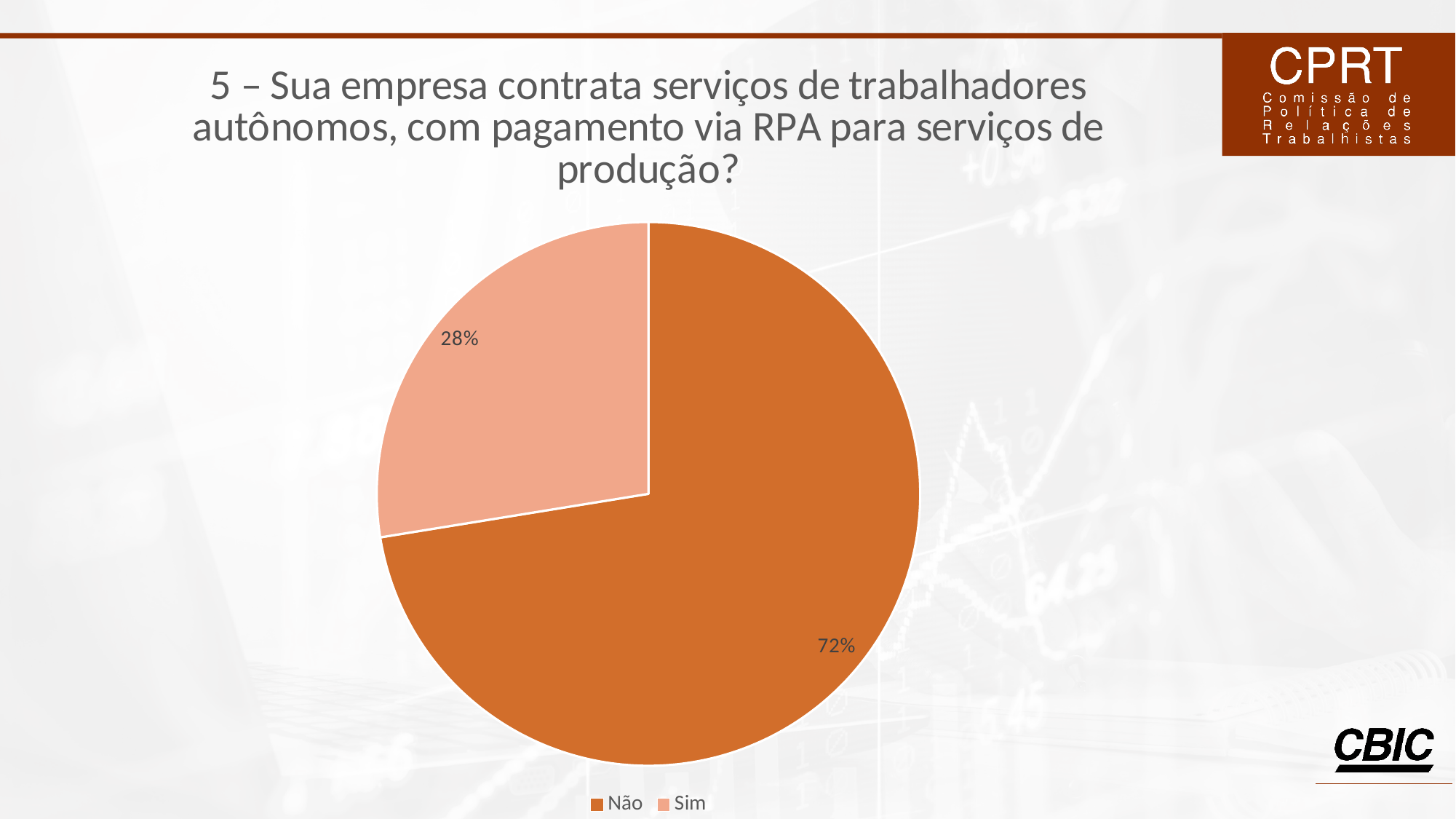
Which legend entry is shown in the darker orange colour? Não What percentage of the pie is labelled "Sim"? 28% What is the title of the chart on the slide? 5 – Sua empresa contrata serviços de trabalhadores autônomos, com pagamento via RPA para serviços de produção? What is the difference in percentage points between the "Não" and "Sim" slices? 44 What share of the pie does the "Sim" slice represent? 28% Which is larger, the "Sim" slice or the "Não" slice? Não Which slice of the pie is the largest? Não What percentage of the pie is labelled "Não"? 72% Which slice of the pie is the smallest? Sim How many slices does the pie chart have? 2 How many entries does the legend list? 2 What kind of chart is shown on the slide? pie chart